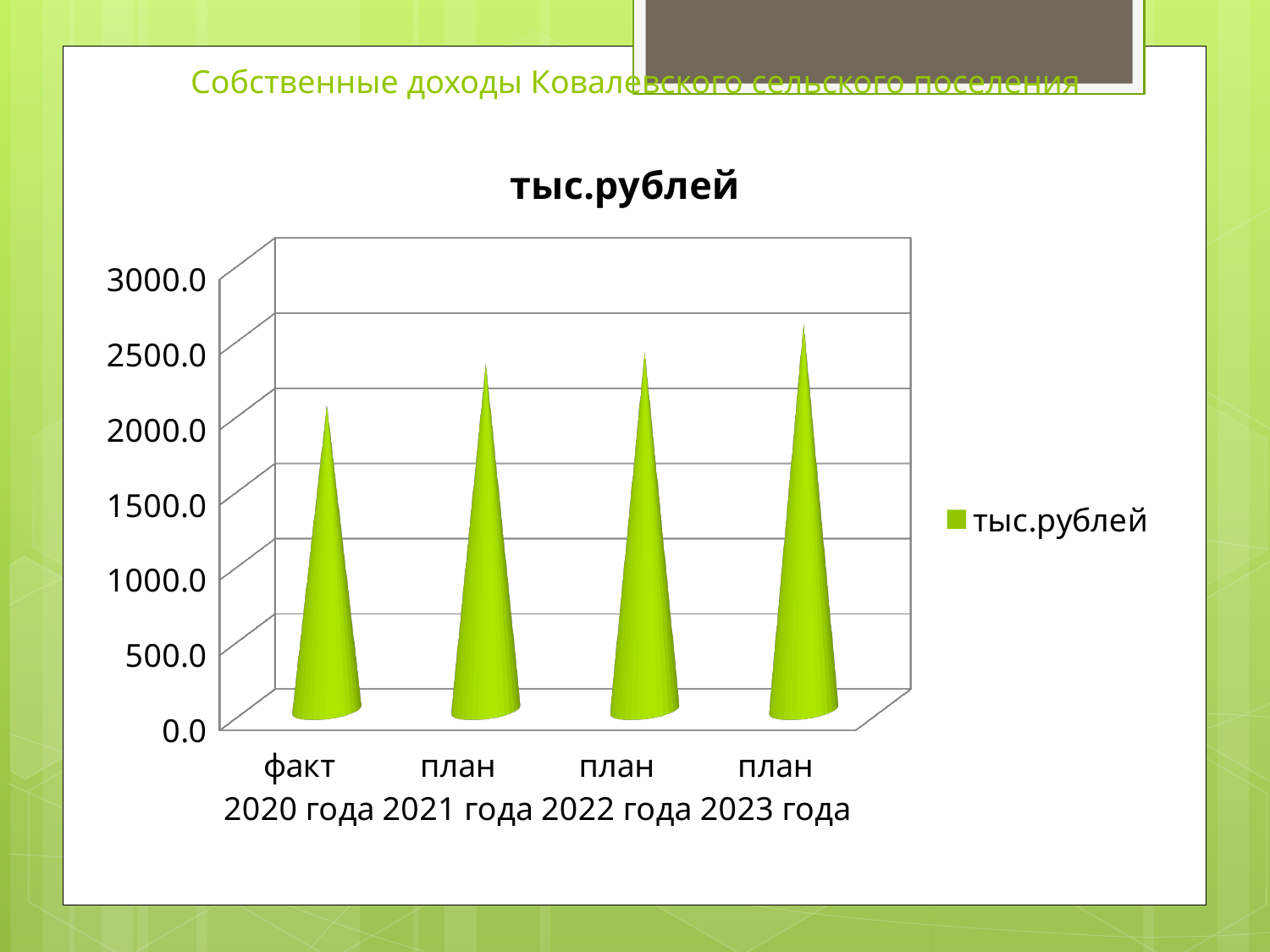
What is the name of the series shown in the legend? тыс.рублей Is the value for план 2022 года greater or less than 1500? greater What kind of chart is shown on the slide? bar chart How many categories are plotted on the chart? 4 Is the value for факт 2020 года greater or less than 2500? less What is the title of the chart? тыс.рублей Which is larger, the value for факт 2020 года or the value for план 2023 года? план 2023 года Do the values rise or fall from факт 2020 года to план 2023 года? rise How many series does the legend list? 1 Which category has the highest value? план 2023 года Which category has the lowest value? факт 2020 года Is the value for план 2023 года greater or less than 2000? greater